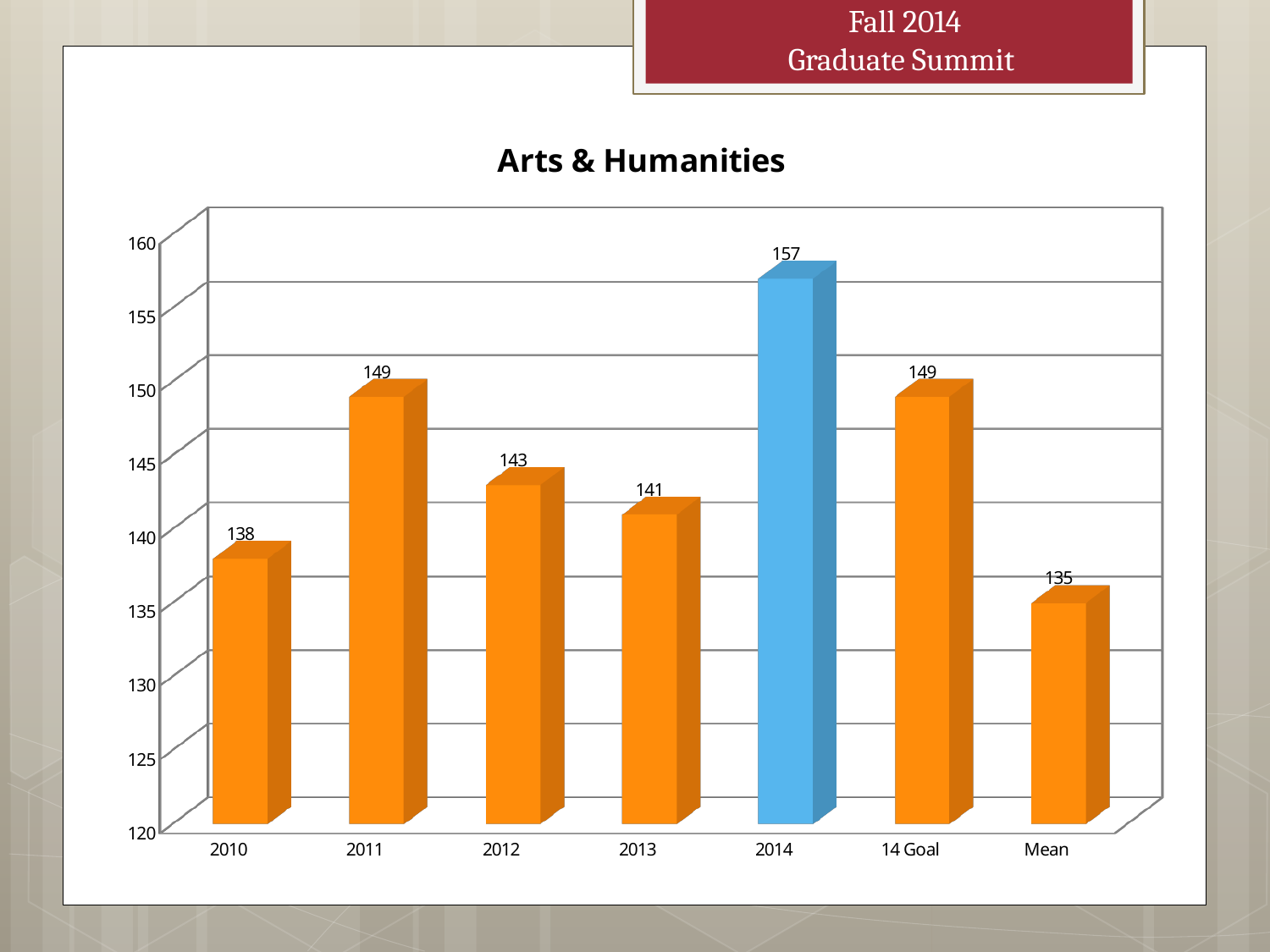
How many categories are shown on the x axis? 7 What is the value for Mean? 135 What kind of chart is shown? bar chart What is the difference between the values for 2011 and 2013? 8 Which category has the lowest value? Mean What is the value for 14 Goal? 149 What is the value for 2014? 157 Which category has the highest value? 2014 What is the value for 2010? 138 Which is larger, the value for 2012 or the value for 2013? 2012 What is the difference between the values for 2014 and 14 Goal? 8 What is the title of the chart? Arts & Humanities